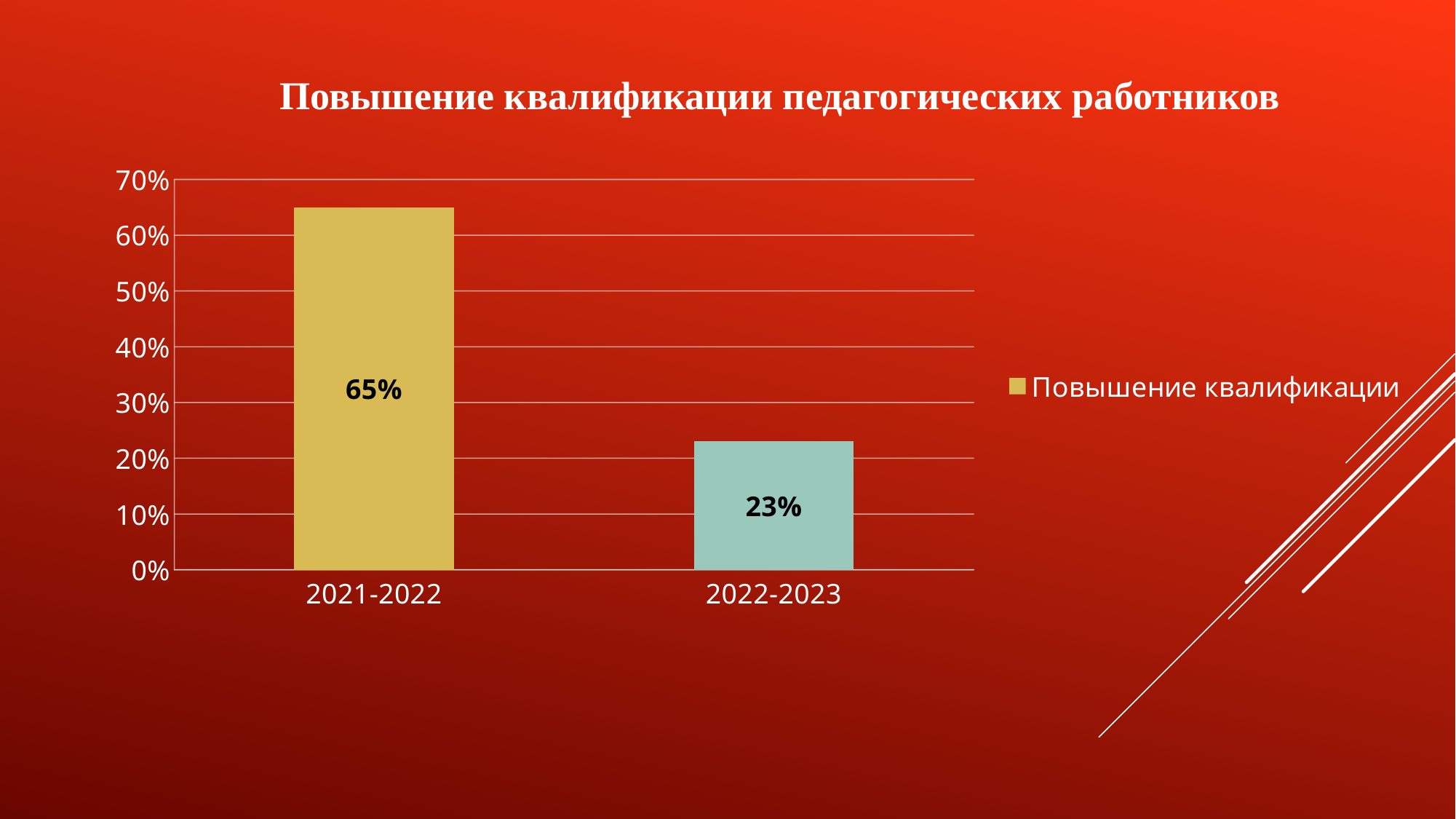
Which category has the highest value? 2021-2022 How many categories are shown on the x axis? 2 How many series does the legend list? 1 Is the value for 2022-2023 greater or less than 30%? less What is the value for 2022-2023? 23% Which is larger, the value for 2021-2022 or the value for 2022-2023? 2021-2022 Do the values rise or fall from 2021-2022 to 2022-2023? fall Which category has the lowest value? 2022-2023 What kind of chart is shown on the slide? bar chart What is the difference between the values for 2021-2022 and 2022-2023? 42% Is the value for 2021-2022 greater or less than 60%? greater What is the value for 2021-2022? 65%